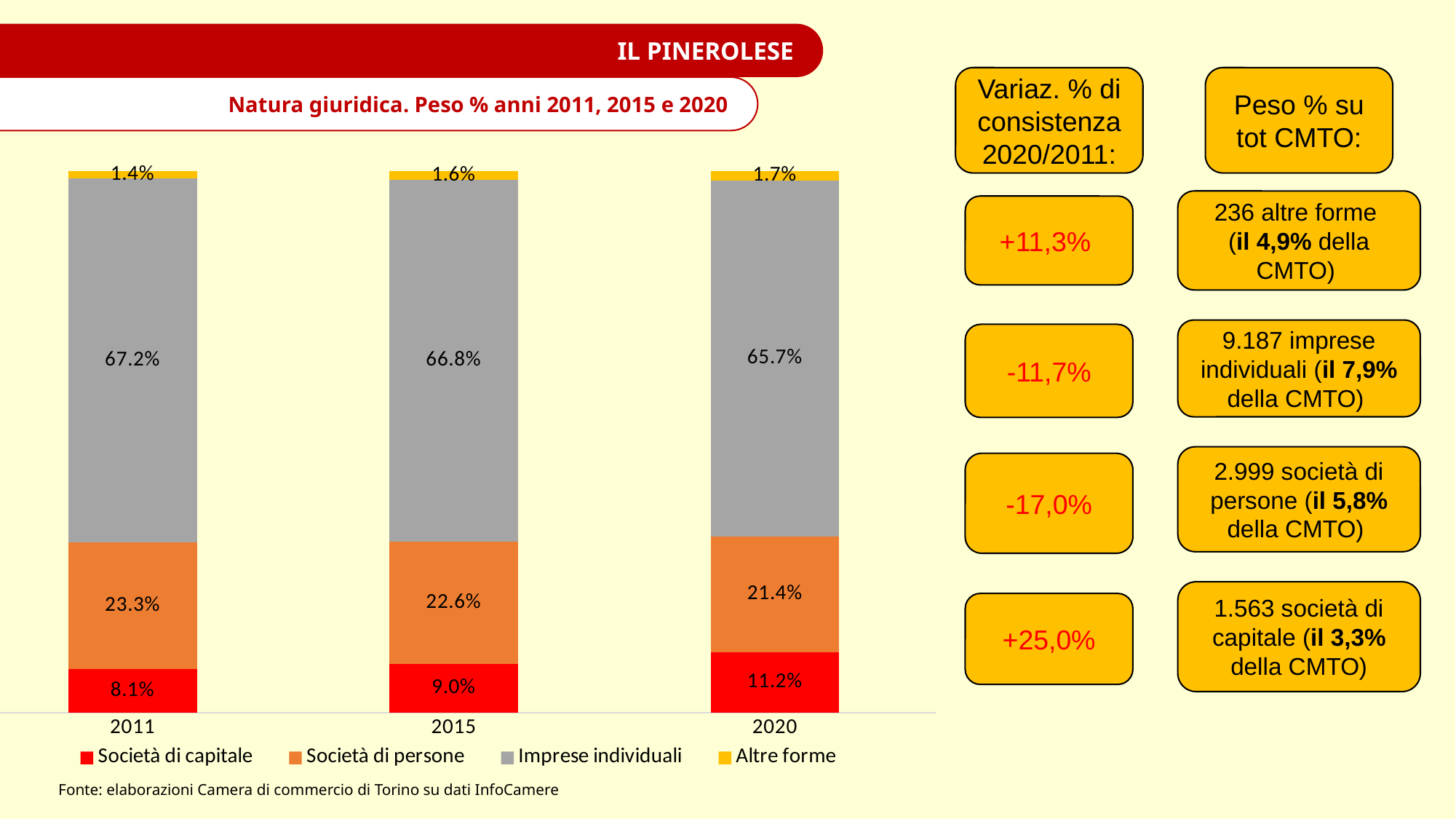
What is the value for Società di persone in 2020? 21.4% What is the value for Società di capitale in 2011? 8.1% What share does Imprese individuali have in 2020? 65.7% How many years are shown on the x axis? 3 How many series does the legend list? 4 What kind of chart is shown? Stacked bar chart Which is larger: Società di capitale in 2015 or Società di capitale in 2020? Società di capitale in 2020 What is the value for Altre forme in 2015? 1.6% Does the share of Società di persone rise or fall from 2011 to 2020? Fall What is the difference between the Società di persone share in 2011 and in 2020? 1.9% In which year is the share of Società di capitale highest? 2020 In which year is the share of Imprese individuali lowest? 2020